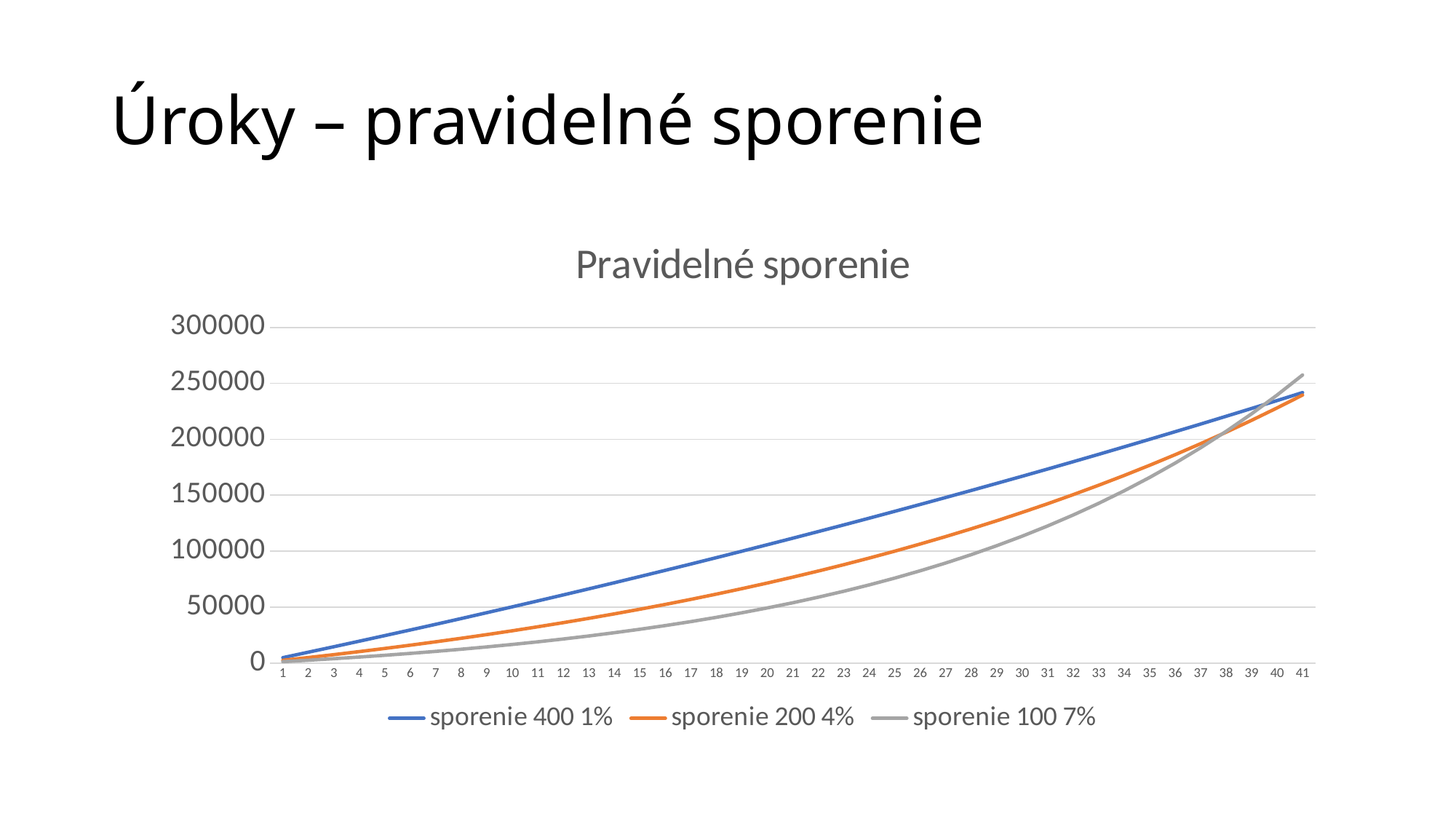
Which series has the highest value at point 41? sporenie 100 7% Which series has the highest value at point 21? sporenie 400 1% Which series has the lowest value at point 21? sporenie 100 7% What is the title of the chart? Pravidelné sporenie Is the value for 'sporenie 400 1%' at point 41 greater or less than 200000? greater Do the values of the 'sporenie 100 7%' series rise or fall along the x axis? rise How many series does the legend list? 3 At point 11, which is larger: 'sporenie 200 4%' or 'sporenie 100 7%'? sporenie 200 4% Which series is drawn in grey? sporenie 100 7% What kind of chart is shown on the slide? line chart Is the value for 'sporenie 100 7%' at point 11 greater or less than 50000? less How many points are plotted along the x axis for each series? 41